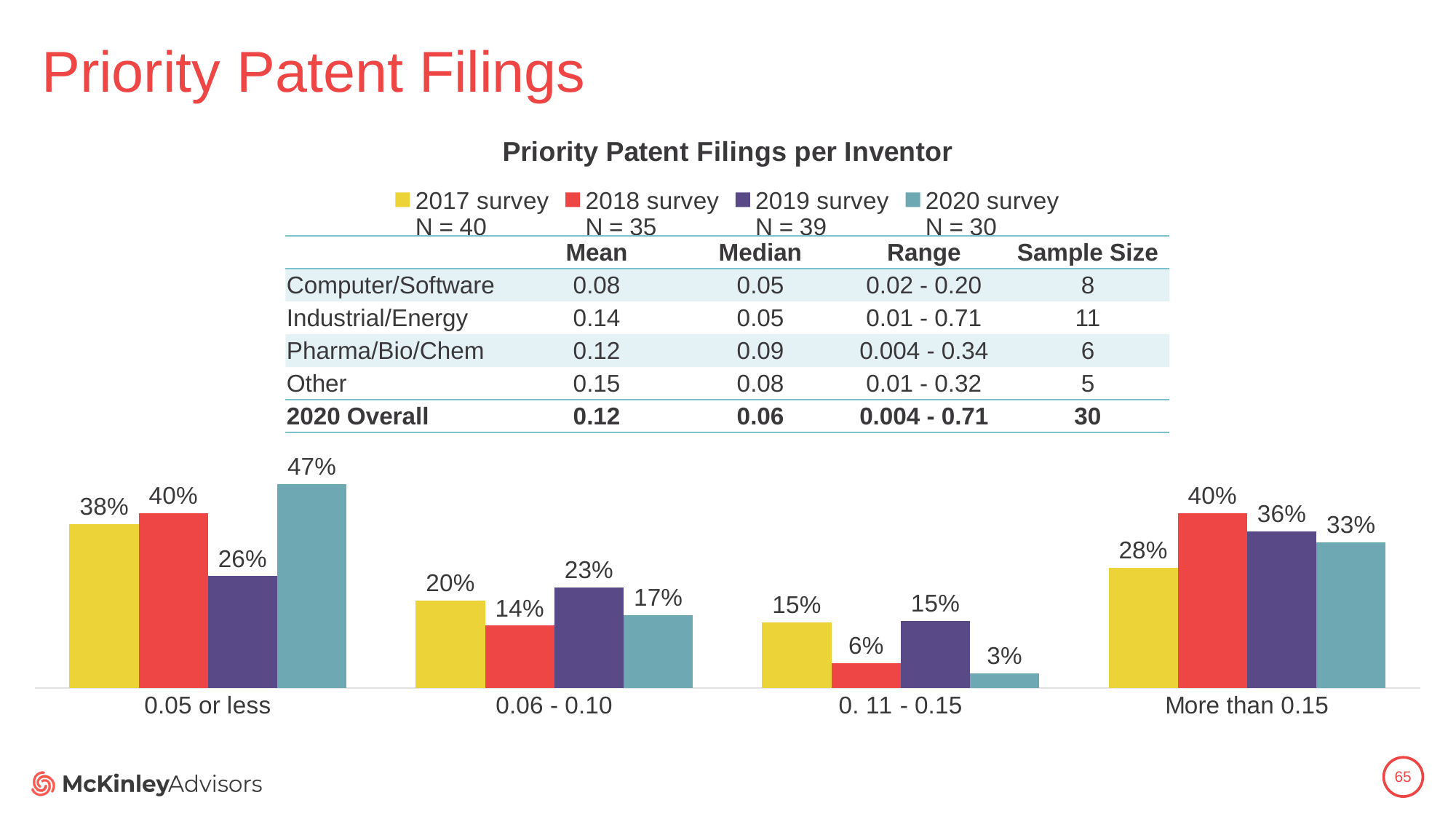
What kind of chart is shown on the slide? bar chart What is the value for the 2020 survey in the "0.05 or less" category? 47% What is the difference between the 2020 survey and 2019 survey values in the "0.05 or less" category? 21% Which survey year has the lowest value in the "0. 11 - 0.15" category? 2020 survey What is the sample size (N) for the 2018 survey shown in the legend? N = 35 What is the value for the 2019 survey in the "More than 0.15" category? 36% Which is larger in the "0.06 - 0.10" category: the 2017 survey value or the 2018 survey value? 2017 survey How many categories are shown on the x axis of the chart? 4 What is the value for the 2018 survey in the "0. 11 - 0.15" category? 6% What is the title of the chart? Priority Patent Filings per Inventor Which survey year has the highest value in the "0.05 or less" category? 2020 survey How many series does the legend list? 4